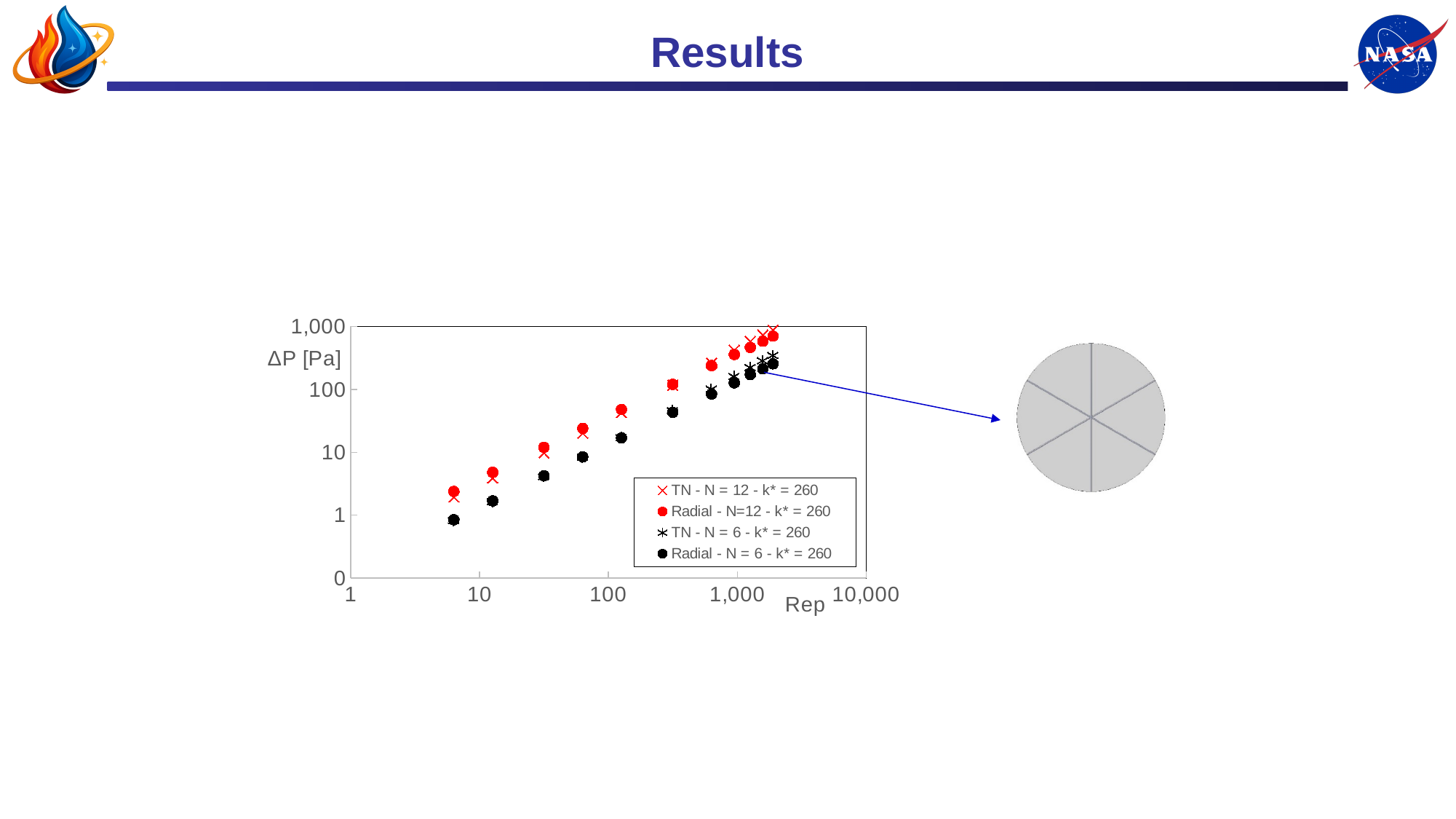
At Rep of about 100, is the value for the Radial - N=12 - k* = 260 series greater or less than 10? greater Which series in the chart are plotted in red? TN - N = 12 - k* = 260 and Radial - N=12 - k* = 260 At Rep of about 100, is the value for the Radial - N = 6 - k* = 260 series greater or less than 100? less At Rep of about 1,000, is the value for the Radial - N=12 - k* = 260 series greater or less than 100? greater What is the label of the x axis? Rep At Rep of about 100, which series has larger ΔP: Radial - N=12 - k* = 260 or Radial - N = 6 - k* = 260? Radial - N=12 - k* = 260 What is the label of the y axis? ΔP [Pa] How many series does the chart's legend list? 4 At the highest Rep values plotted, which series has larger ΔP: TN - N = 12 - k* = 260 or TN - N = 6 - k* = 260? TN - N = 12 - k* = 260 Do the ΔP values rise or fall as Rep increases along the x axis? Rise What kind of chart is shown on the slide? Scatter plot